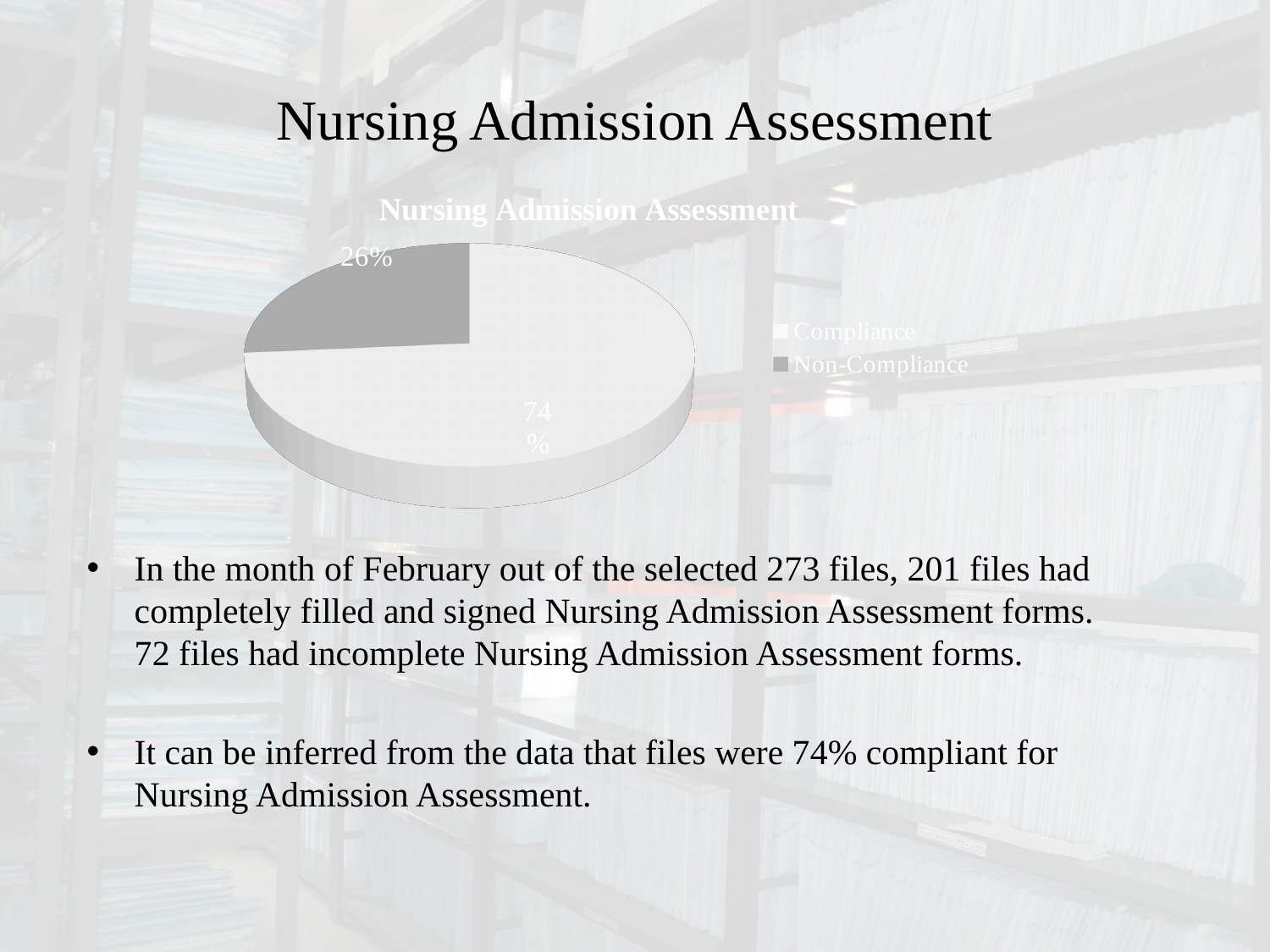
Which slice of the pie is the largest? Compliance What share of the pie does Compliance represent? 74% What is the title of the chart? Nursing Admission Assessment What kind of chart is shown on the slide? pie chart What is the difference in percentage points between the Compliance and Non-Compliance slices? 48 How many entries does the legend list? 2 Which is larger, the Compliance slice or the Non-Compliance slice? Compliance How many slices does the pie chart have? 2 Which legend entry is shown in the darker grey colour? Non-Compliance Which slice of the pie is the smallest? Non-Compliance What share of the pie does Non-Compliance represent? 26%